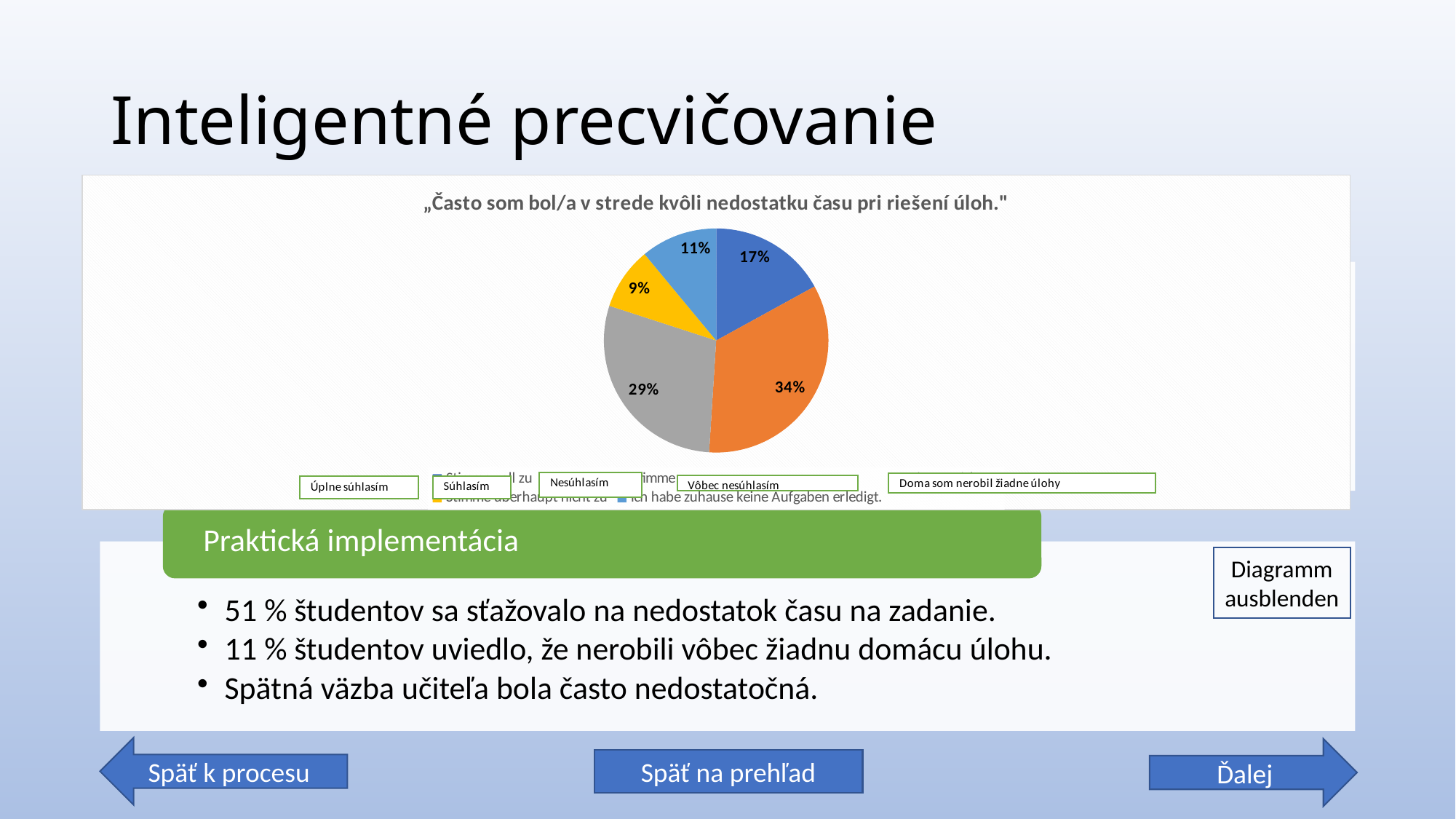
What percentage is shown on the gray slice of the pie chart? 29% How many slices does the pie chart have? 5 What is the title of the pie chart? „Často som bol/a v strede kvôli nedostatku času pri riešení úloh." What percentage is shown on the yellow slice of the pie chart? 9% Which is larger in the pie chart: the dark blue slice or the light blue slice? the dark blue slice (17%) Which slice of the pie chart is the largest? 34% (Súhlasím) Which slice of the pie chart is the smallest? 9% (Vôbec nesúhlasím) What kind of chart is shown on the slide? pie chart What share of the pie corresponds to 'Úplne súhlasím'? 17% What share of the pie corresponds to 'Doma som nerobil žiadne úlohy'? 11% What is the difference between the orange slice (34%) and the gray slice (29%)? 5% What percentage is shown on the orange slice of the pie chart? 34%